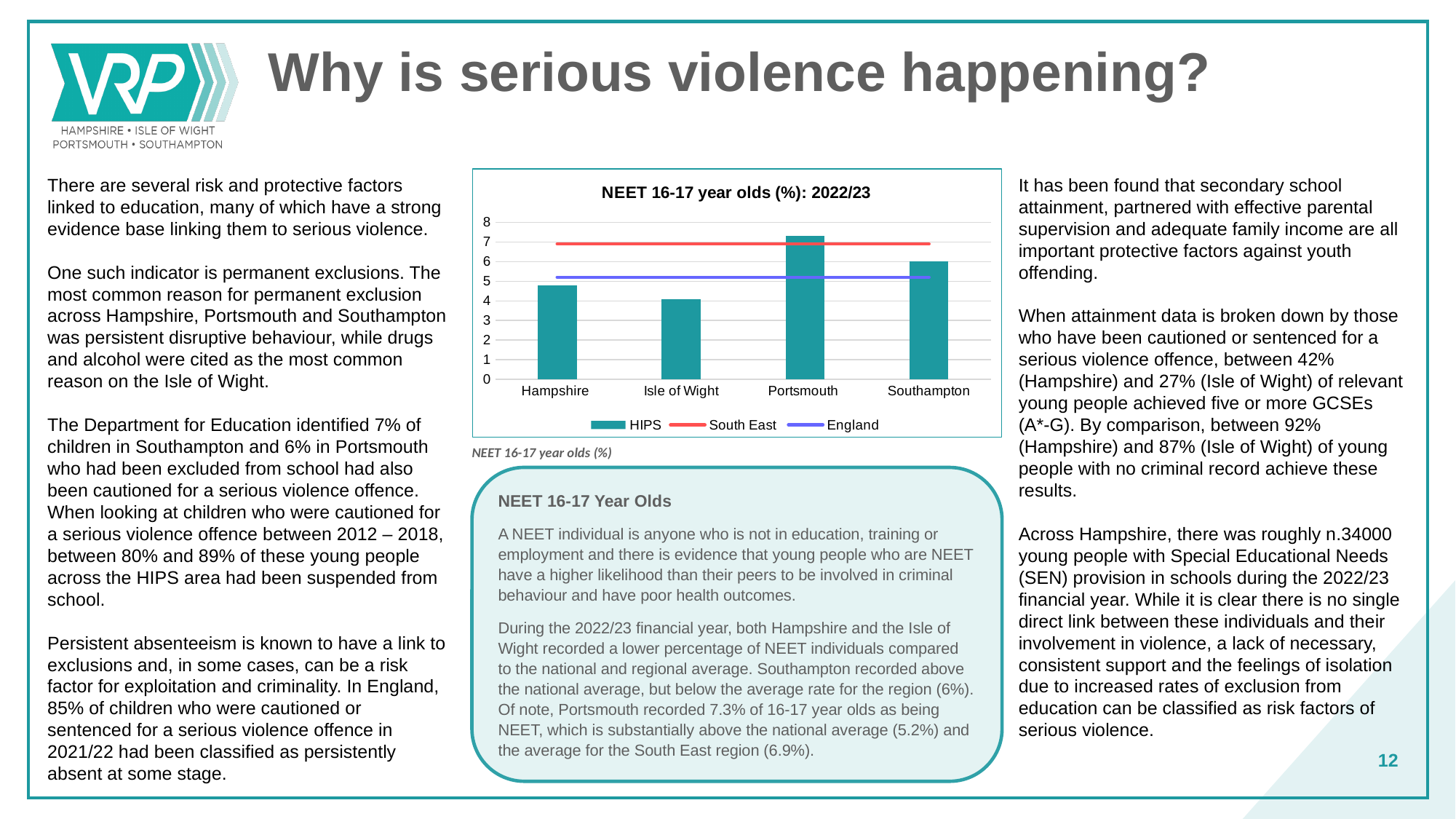
Which area has the highest NEET percentage bar? Portsmouth Is the bar for Isle of Wight greater or less than 5? less Which has the larger bar, Southampton or Hampshire? Southampton How many series does the chart's legend list? 3 What kind of chart is used to show the HIPS values? Bar chart How many areas are shown on the x axis of the chart? 4 Which legend entry is shown as a red line? South East What is the title of the chart? NEET 16-17 year olds (%): 2022/23 Which area has the lowest NEET percentage bar? Isle of Wight Is the bar for Portsmouth greater or less than 7? greater Is the bar for Southampton greater or less than 5? greater